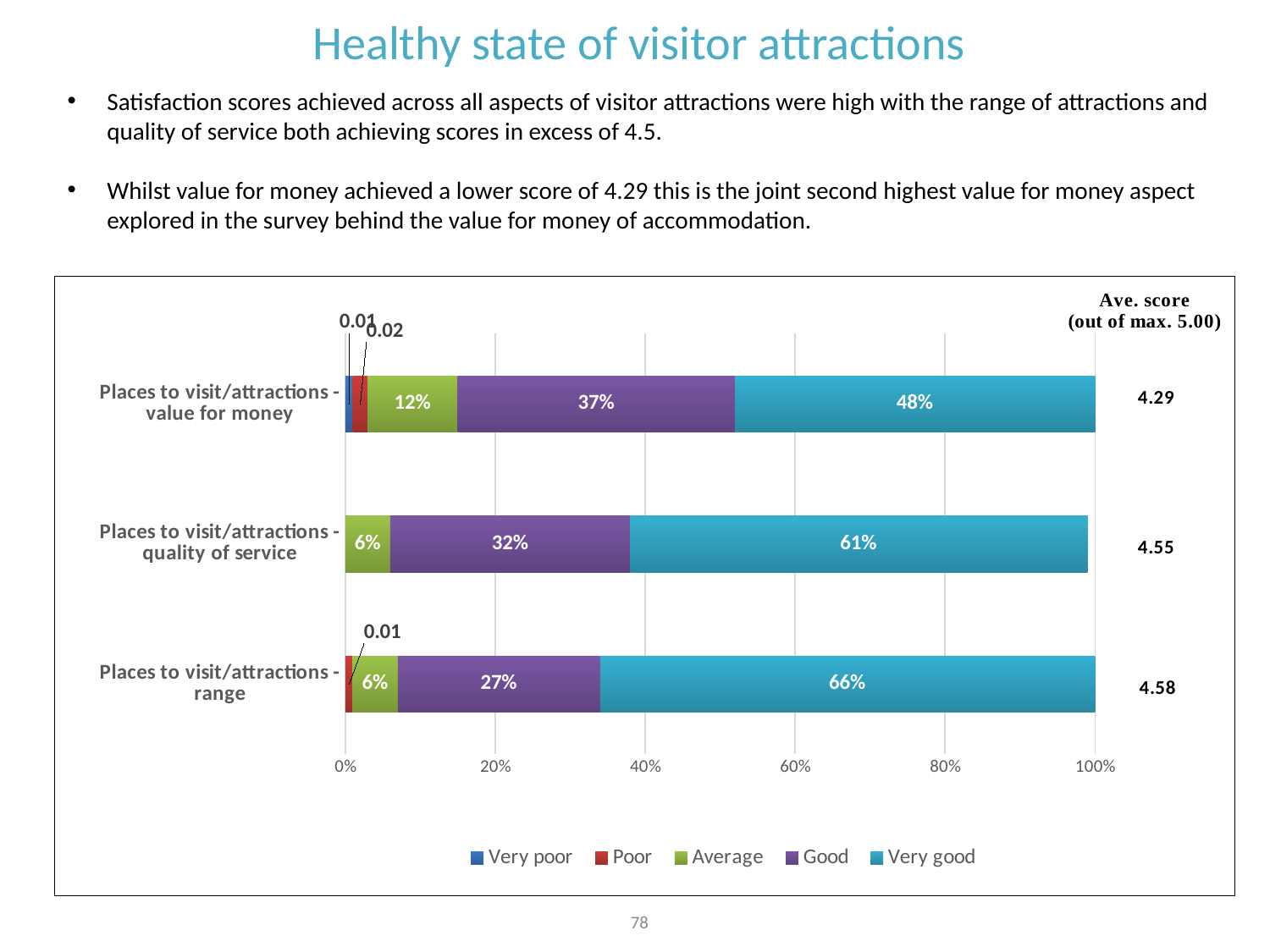
What is the 'Very good' value for 'Places to visit/attractions - quality of service'? 61% How many series does the legend list? 5 What kind of chart is shown on the slide? Stacked bar chart What is the difference between the 'Very good' values for 'Places to visit/attractions - range' and 'Places to visit/attractions - value for money'? 18% Which category has the highest 'Very good' value? Places to visit/attractions - range Which category has the lowest 'Very good' value? Places to visit/attractions - value for money What is the 'Good' value for 'Places to visit/attractions - value for money'? 37% What is the 'Average' value for 'Places to visit/attractions - quality of service'? 6% What is the 'Very good' value for 'Places to visit/attractions - range'? 66% How many categories are plotted on the chart? 3 Which is larger: the 'Good' value for 'Places to visit/attractions - quality of service' or for 'Places to visit/attractions - range'? Places to visit/attractions - quality of service What average score (out of max. 5.00) is shown for 'Places to visit/attractions - quality of service'? 4.55